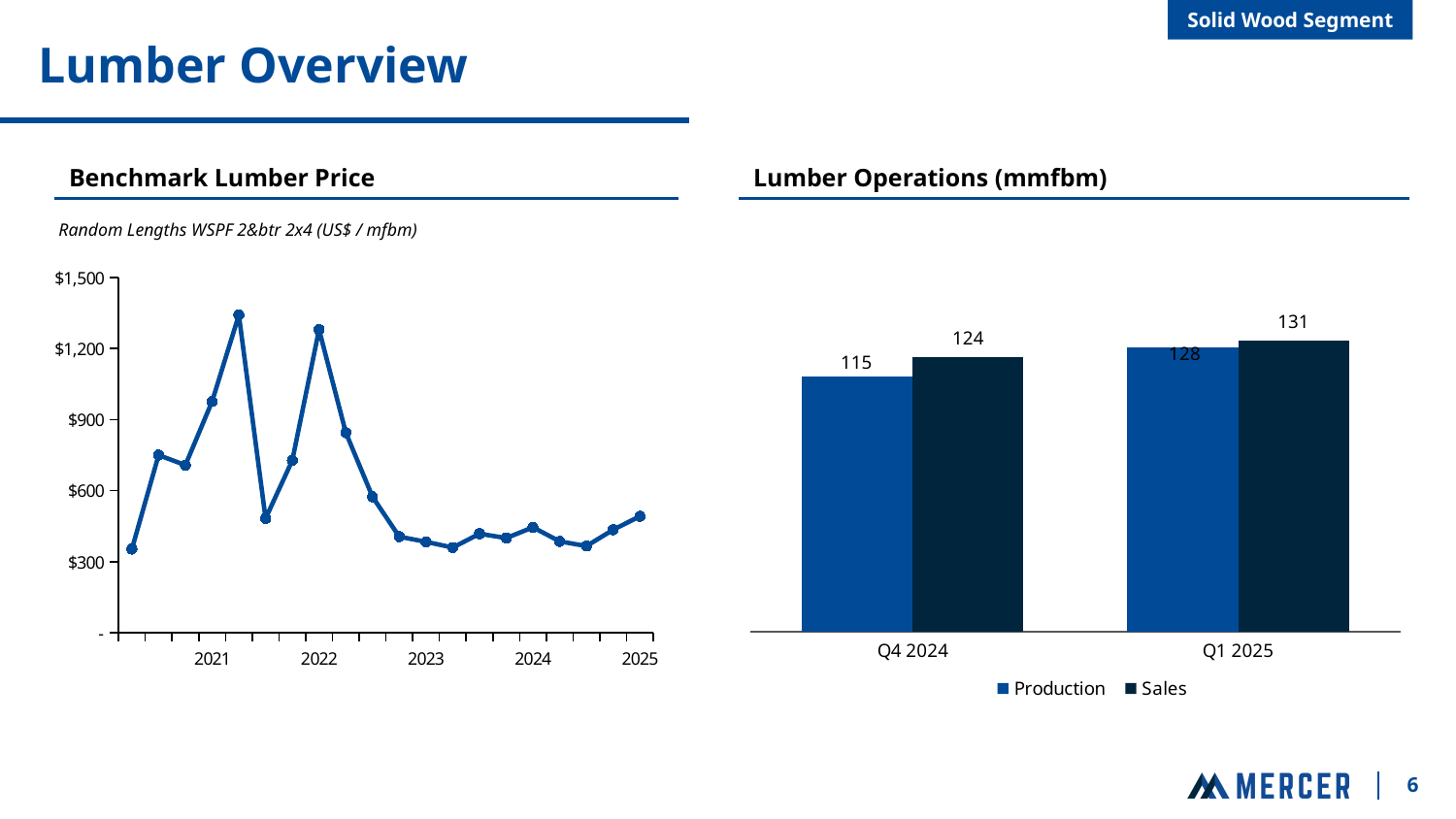
What kind of chart is the Lumber Operations (mmfbm) chart? Bar chart In the Benchmark Lumber Price chart, is the value at the start of 2025 greater or less than $600? less In the Benchmark Lumber Price chart, is the peak value in 2021 greater or less than $1,200? greater What kind of chart is the Benchmark Lumber Price chart? Line chart How many series does the legend of the Lumber Operations (mmfbm) chart list? 2 In the Lumber Operations (mmfbm) chart, by how much did Production increase from Q4 2024 to Q1 2025? 13 In the Lumber Operations (mmfbm) chart, what is the Production value for Q4 2024? 115 In the Lumber Operations (mmfbm) chart, what is the difference between Sales and Production in Q4 2024? 9 In the Lumber Operations (mmfbm) chart, which is larger in Q1 2025, Production or Sales? Sales In the Lumber Operations (mmfbm) chart, what is the Production value for Q1 2025? 128 In the Lumber Operations (mmfbm) chart, what is the Sales value for Q1 2025? 131 In the Lumber Operations (mmfbm) chart, what is the Sales value for Q4 2024? 124